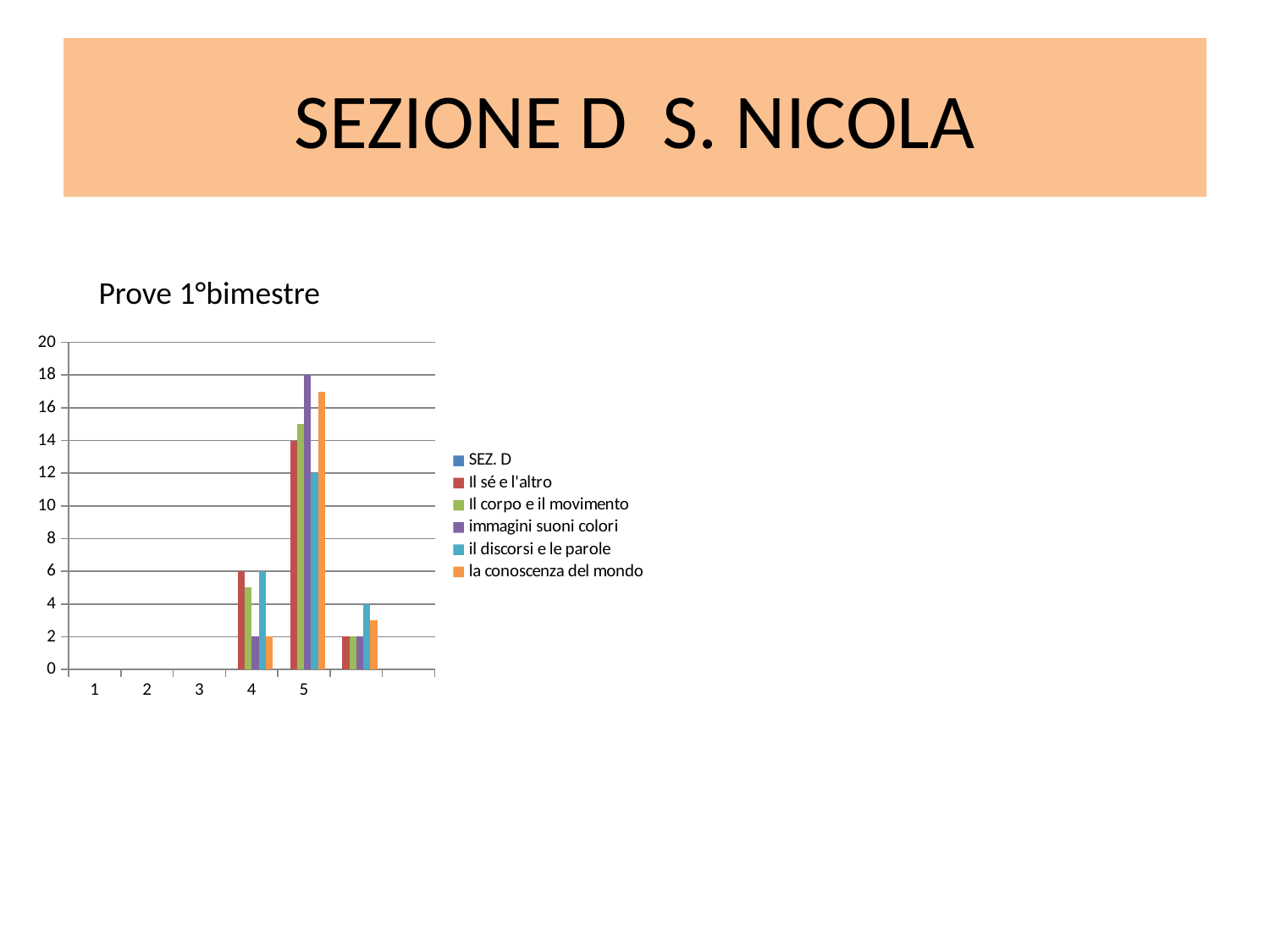
Is the value for Il corpo e il movimento at category 5 greater or less than 10? greater At category 5, which series has the lowest bar? il discorsi e le parole What is the value for immagini suoni colori at category 5? 18 What is the title of the chart? Prove 1°bimestre Is the value for la conoscenza del mondo at category 5 greater or less than 16? greater What is the value for il discorsi e le parole at category 5? 12 At category 5, which series has the highest bar? immagini suoni colori What is the value for Il sé e l'altro at category 4? 6 At category 4, which is larger: Il sé e l'altro or immagini suoni colori? Il sé e l'altro How many series does the legend of the chart list? 6 At category 5, what is the difference between immagini suoni colori and il discorsi e le parole? 6 What kind of chart is shown on the slide? bar chart